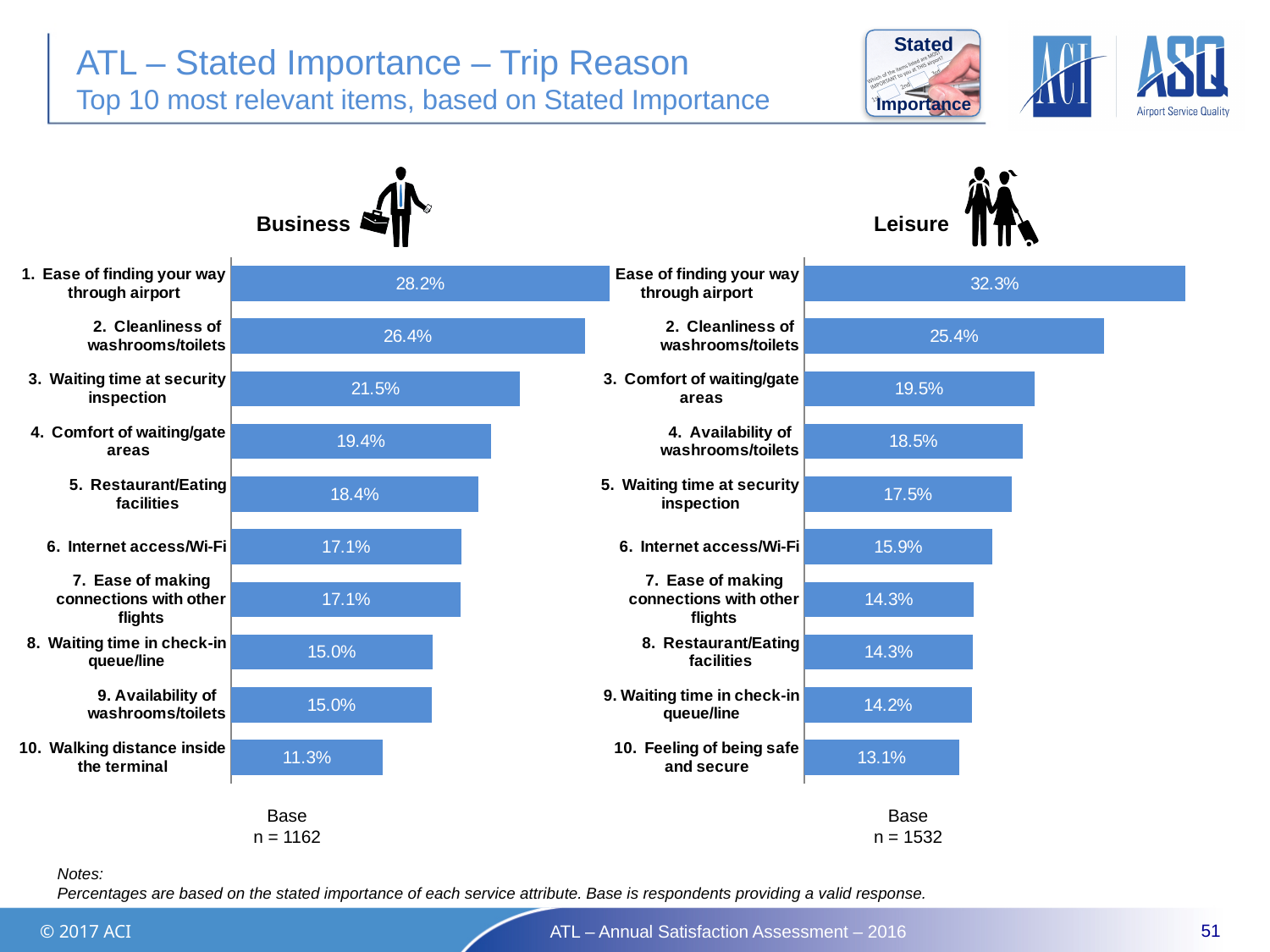
How many items are shown in the Leisure chart? 10 What kind of chart is used for the Business data? Bar chart In the Leisure chart, what is the value for Cleanliness of washrooms/toilets? 25.4% What is the difference between the Business and Leisure values for Ease of finding your way through airport? 4.1% In the Business chart, which item has the lowest value? Walking distance inside the terminal Which is larger: the Business value for Internet access/Wi-Fi or the Leisure value for Internet access/Wi-Fi? Business What is the base (n) for the Leisure chart? n = 1532 In the Business chart, what is the value for Walking distance inside the terminal? 11.3% In the Leisure chart, what is the value for Feeling of being safe and secure? 13.1% In the Business chart, what is the difference between Waiting time at security inspection and Comfort of waiting/gate areas? 2.1% In the Business chart, what is the value for Ease of finding your way through airport? 28.2% In the Leisure chart, which item has the highest value? Ease of finding your way through airport